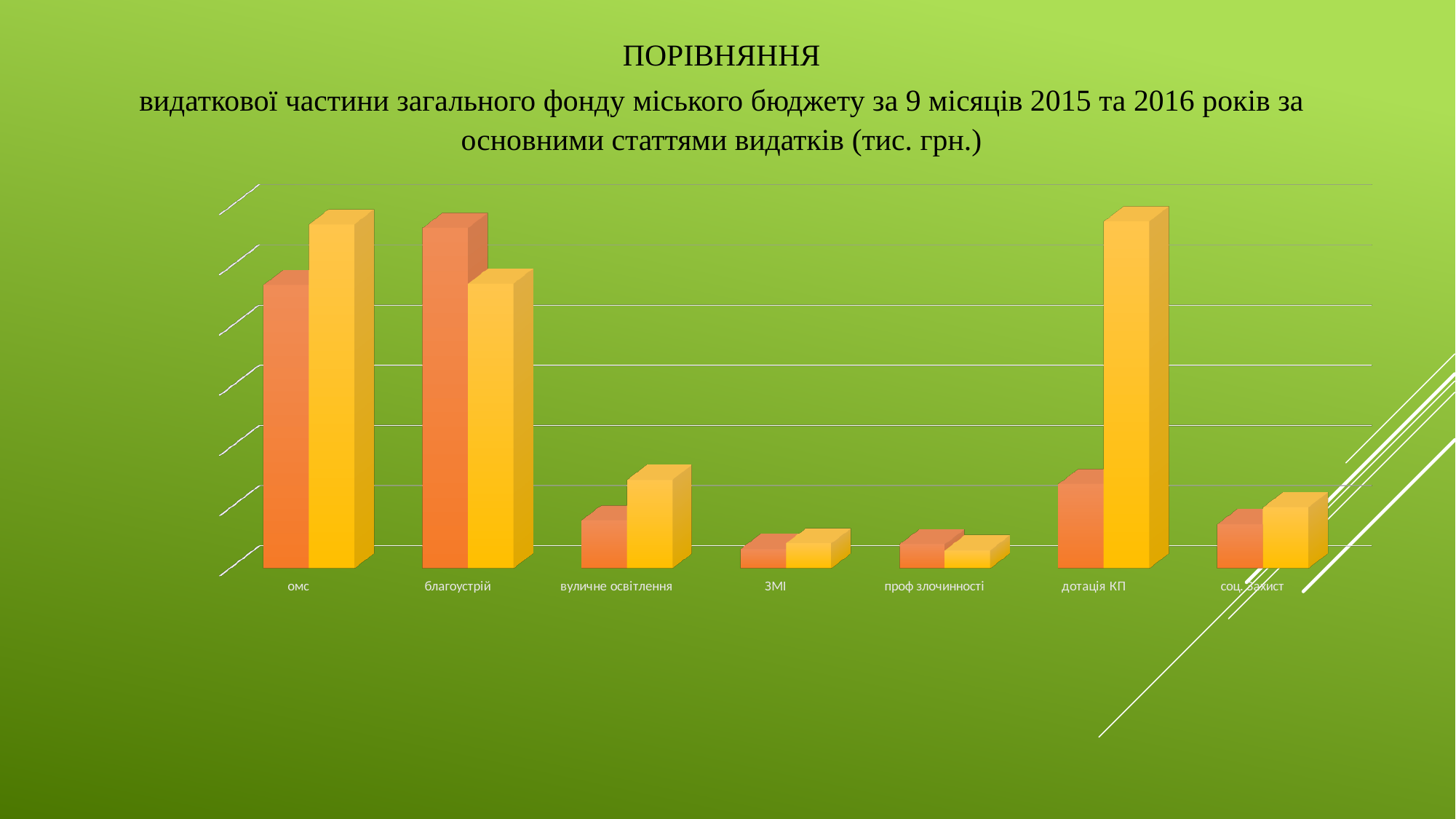
Which has the taller orange bar, омс or вуличне освітлення? омс For дотація КП, which bar is taller, the orange one or the yellow one? yellow Which category has the tallest orange bar? благоустрій Which has the taller yellow bar, благоустрій or соц. захист? благоустрій How many bars are plotted for each category? 2 In what units does the title say the values are expressed? тис. грн. Which two years does the chart title say are being compared? 2015 and 2016 How many expenditure categories are shown along the x axis? 7 What kind of chart is shown on the slide? bar chart